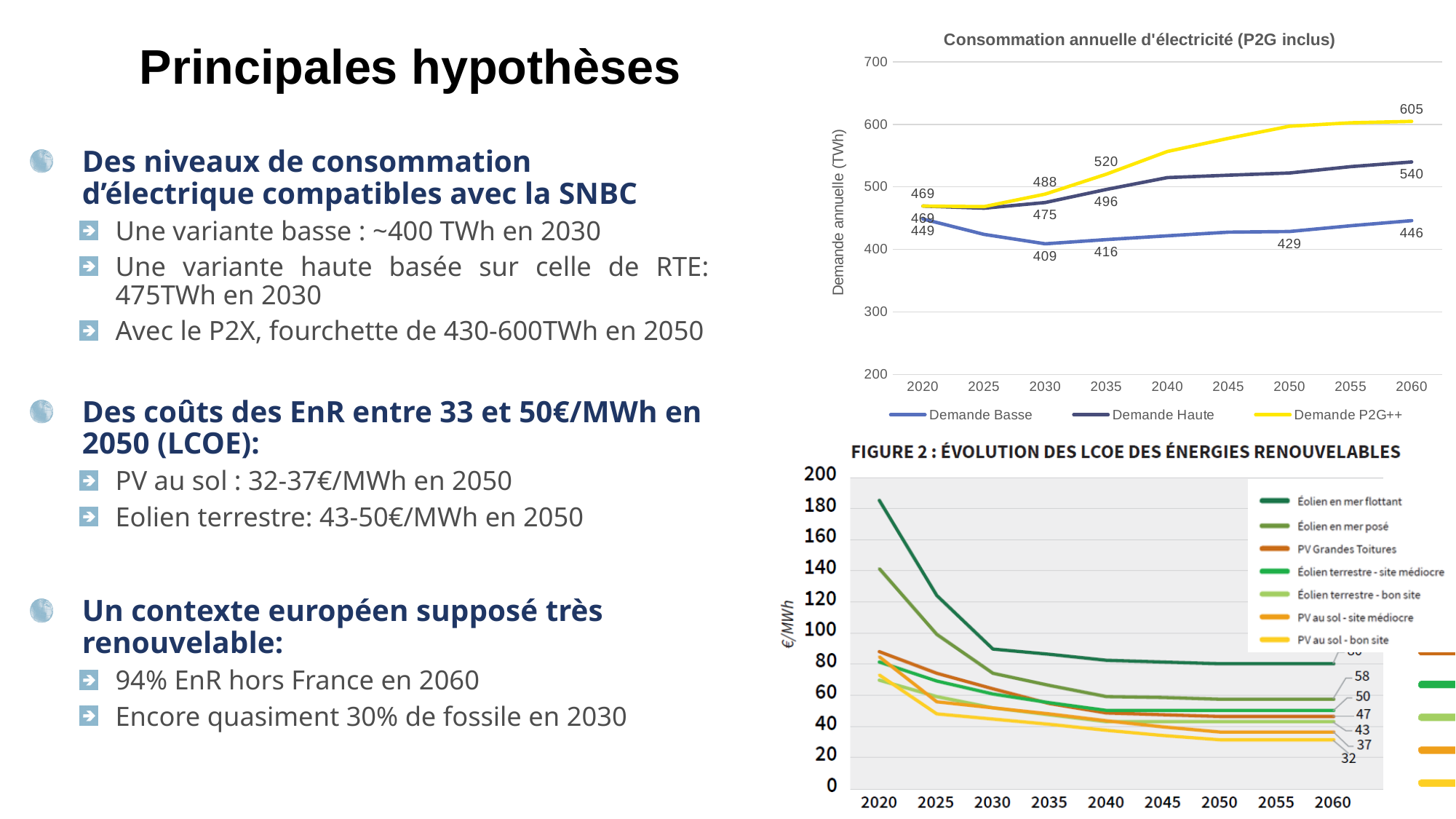
On the chart 'Consommation annuelle d'électricité (P2G inclus)', how many series does the legend list? 3 On the chart 'Consommation annuelle d'électricité (P2G inclus)', which series has the highest value in 2060? Demande P2G++ On the chart 'Consommation annuelle d'électricité (P2G inclus)', what is the value of Demande P2G++ in 2060? 605 On the chart 'FIGURE 2 : ÉVOLUTION DES LCOE DES ÉNERGIES RENOUVELABLES', how many series does the legend list? 7 On the chart 'Consommation annuelle d'électricité (P2G inclus)', does Demande P2G++ rise or fall between 2020 and 2060? rise On the chart 'Consommation annuelle d'électricité (P2G inclus)', what is the value of Demande Basse in 2050? 429 On the chart 'Consommation annuelle d'électricité (P2G inclus)', what is the value of Demande Haute in 2060? 540 On the chart 'Consommation annuelle d'électricité (P2G inclus)', what is the difference between Demande Basse in 2060 and in 2030? 37 On the chart 'Consommation annuelle d'électricité (P2G inclus)', what is the difference between Demande P2G++ and Demande Haute in 2060? 65 On the chart 'Consommation annuelle d'électricité (P2G inclus)', what is the value of Demande Basse in 2030? 409 What kind of chart is 'FIGURE 2 : ÉVOLUTION DES LCOE DES ÉNERGIES RENOUVELABLES'? line chart On the chart 'FIGURE 2 : ÉVOLUTION DES LCOE DES ÉNERGIES RENOUVELABLES', is the value for Éolien en mer flottant in 2020 greater or less than 160? greater